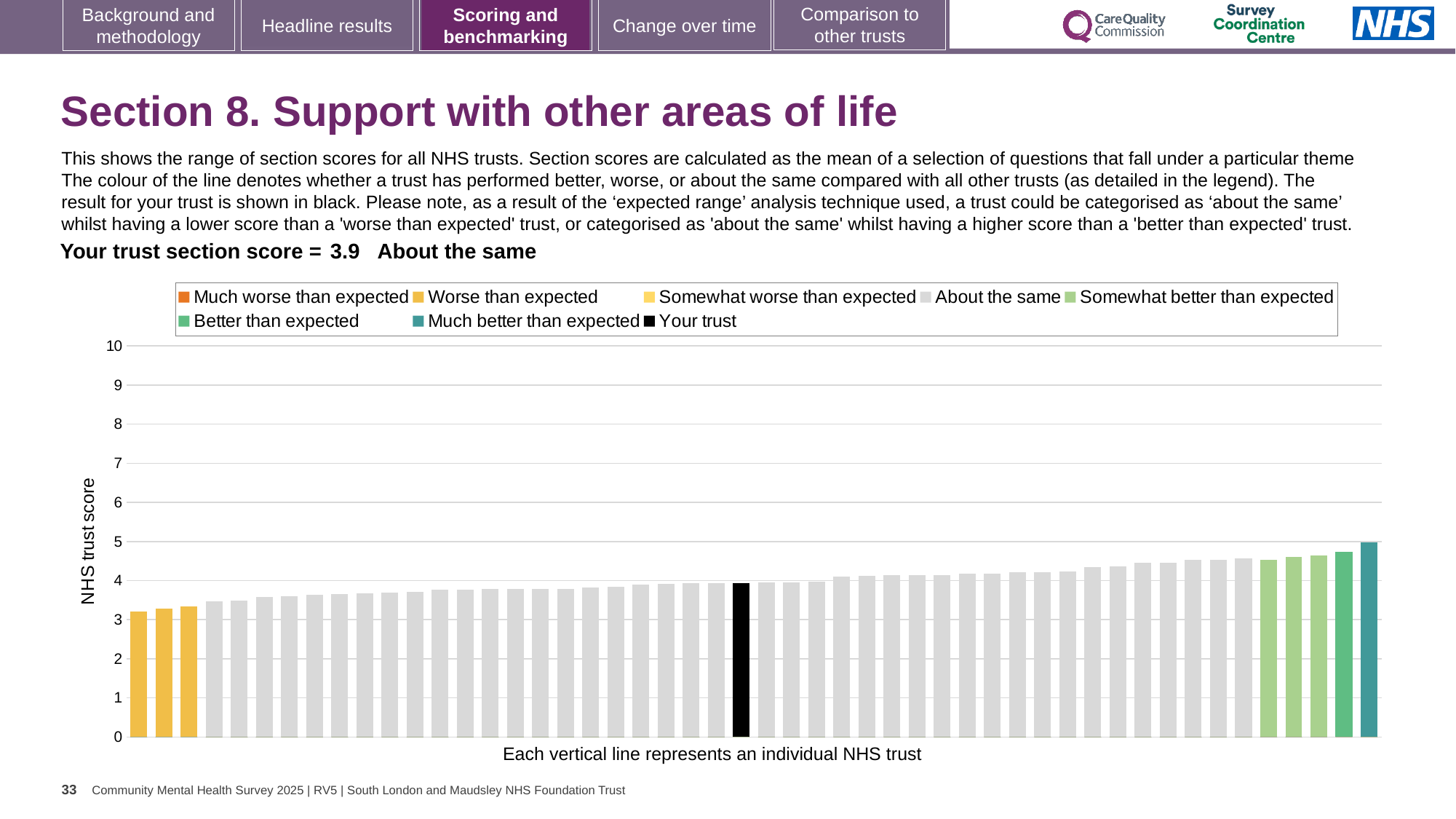
Is the value for your trust (the black bar) greater or less than 3? greater Is the value of the tallest bar greater or less than 4? greater How many bars are coloured as 'Worse than expected'? 3 Do the bar values rise or fall from left to right along the x axis? rise What kind of chart is shown on the slide? bar chart Which category is your trust placed in for this section? About the same Which legend category does the tallest bar belong to? Much better than expected What is the section score for your trust as stated on the slide? 3.9 What is the label on the y axis of the chart? NHS trust score Which is larger, the rightmost bar or the leftmost bar? the rightmost bar How many entries does the chart legend list? 8 Is the value of the leftmost bar greater or less than 4? less